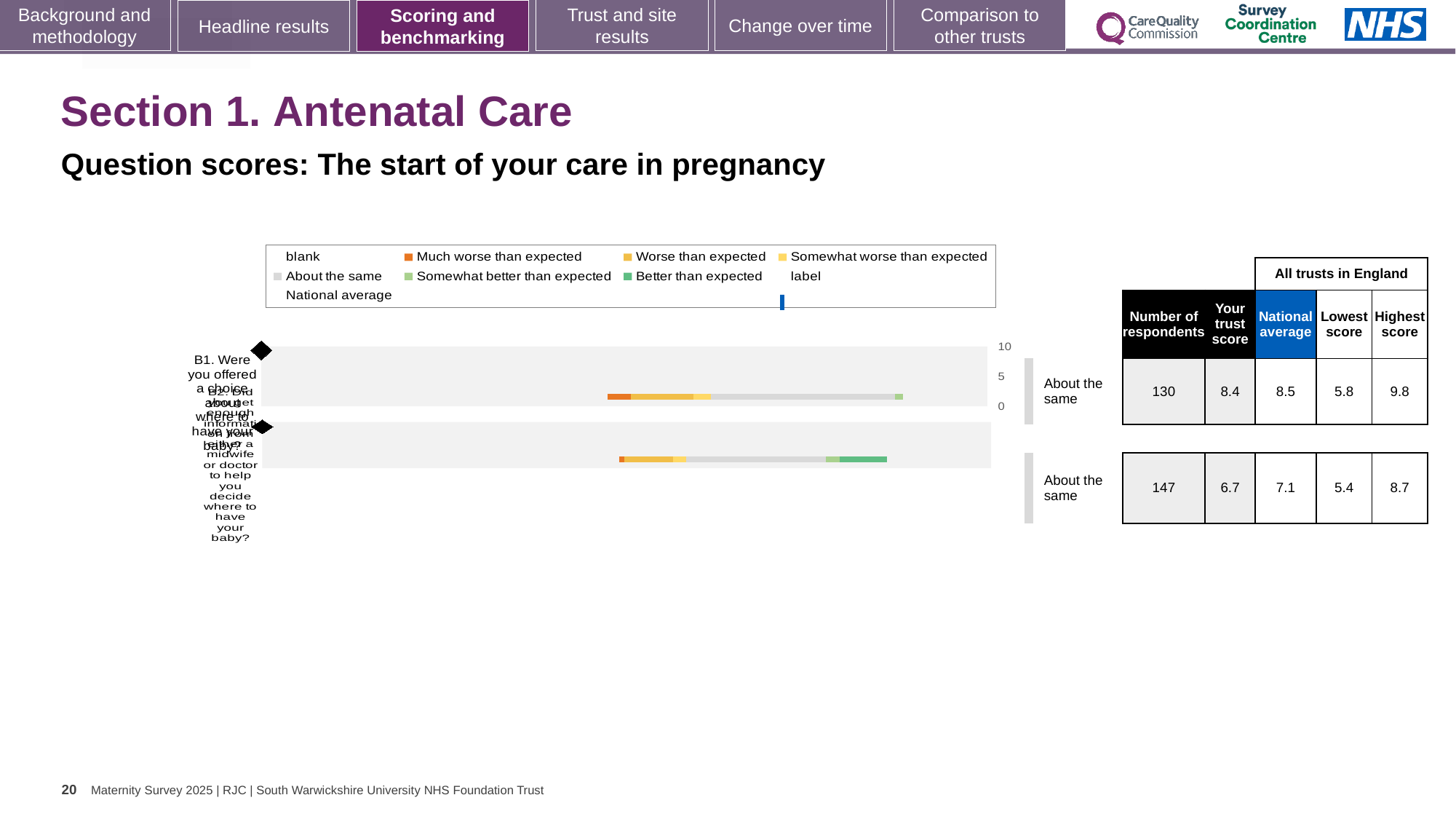
What is the trust's score for question B1 (Were you offered a choice about where to have your baby?)? 8.4 What is the difference between the national average and the trust's score for the second question row (B2)? 0.4 What is the national average for question B1 (Were you offered a choice about where to have your baby?)? 8.5 How many respondents are listed for question B1 (Were you offered a choice about where to have your baby?)? 130 Which question has the higher trust score, B1 or the second question row (B2)? B1 What is the lowest score among all trusts in England for question B1? 5.8 What is the difference between the highest and lowest scores for question B1? 4.0 What colour does the legend use for 'Much worse than expected'? Orange What is the highest score among all trusts in England for question B1? 9.8 How many respondents are listed for the second question row (B2)? 147 What is the trust's score for the second question row (B2)? 6.7 What benchmark category is shown for question B1? About the same